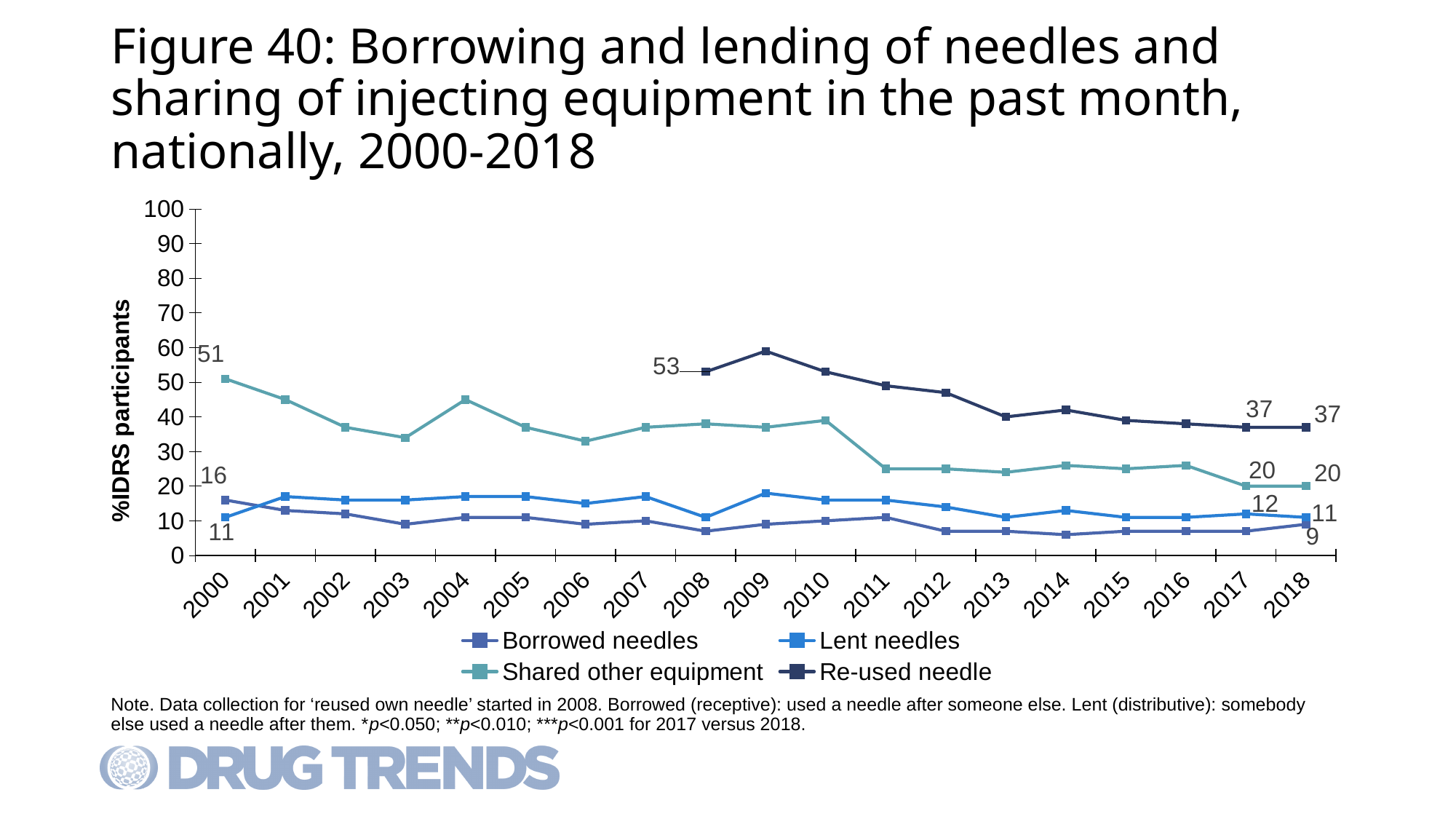
What is the value for Re-used needle in 2008? 53 Does the Shared other equipment series rise or fall from 2000 to 2018? fall What is the value for Re-used needle in 2018? 37 Is the value for Re-used needle in 2009 greater or less than 50? greater In 2018, which is larger: Re-used needle or Shared other equipment? Re-used needle What is the value for Shared other equipment in 2000? 51 How many series does the legend list? 4 How many years are shown on the x axis? 19 What kind of chart is shown on the slide? line chart What is the value for Lent needles in 2017? 12 What is the value for Borrowed needles in 2018? 9 What is the difference between the Shared other equipment values in 2000 and 2018? 31